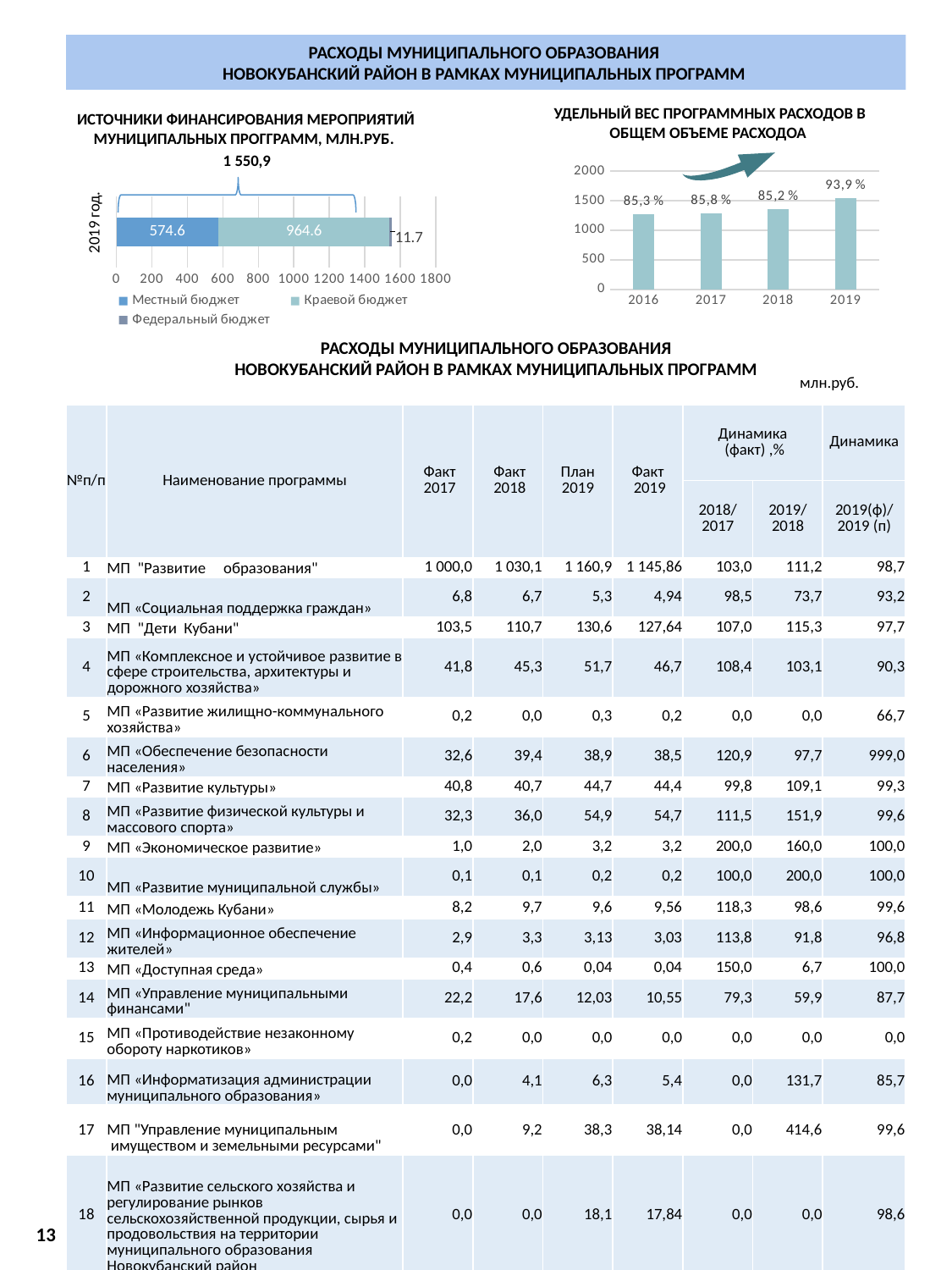
In the chart 'Источники финансирования мероприятий муниципальных программ, млн.руб.', which budget source has the smallest value? Федеральный бюджет In the chart 'Источники финансирования мероприятий муниципальных программ, млн.руб.', what is the value for Краевой бюджет? 964.6 In the chart 'Удельный вес программных расходов в общем объеме расходоа', which year has the highest value? 2019 In the chart 'Источники финансирования мероприятий муниципальных программ, млн.руб.', what is the value for Федеральный бюджет? 11.7 In the chart 'Источники финансирования мероприятий муниципальных программ, млн.руб.', what is the value for Местный бюджет? 574.6 In the chart 'Источники финансирования мероприятий муниципальных программ, млн.руб.', which budget source has the largest value? Краевой бюджет In the chart 'Удельный вес программных расходов в общем объеме расходоа', how many years are shown on the x axis? 4 In the chart 'Источники финансирования мероприятий муниципальных программ, млн.руб.', how many series does the legend list? 3 What kind of chart is 'Удельный вес программных расходов в общем объеме расходоа'? Bar chart In the chart 'Удельный вес программных расходов в общем объеме расходоа', what is the value labelled for 2019? 93,9 % In the chart 'Источники финансирования мероприятий муниципальных программ, млн.руб.', what is the total shown above the stacked bar for 2019 год? 1 550,9 In the chart 'Удельный вес программных расходов в общем объеме расходоа', what is the value labelled for 2017? 85,8 %